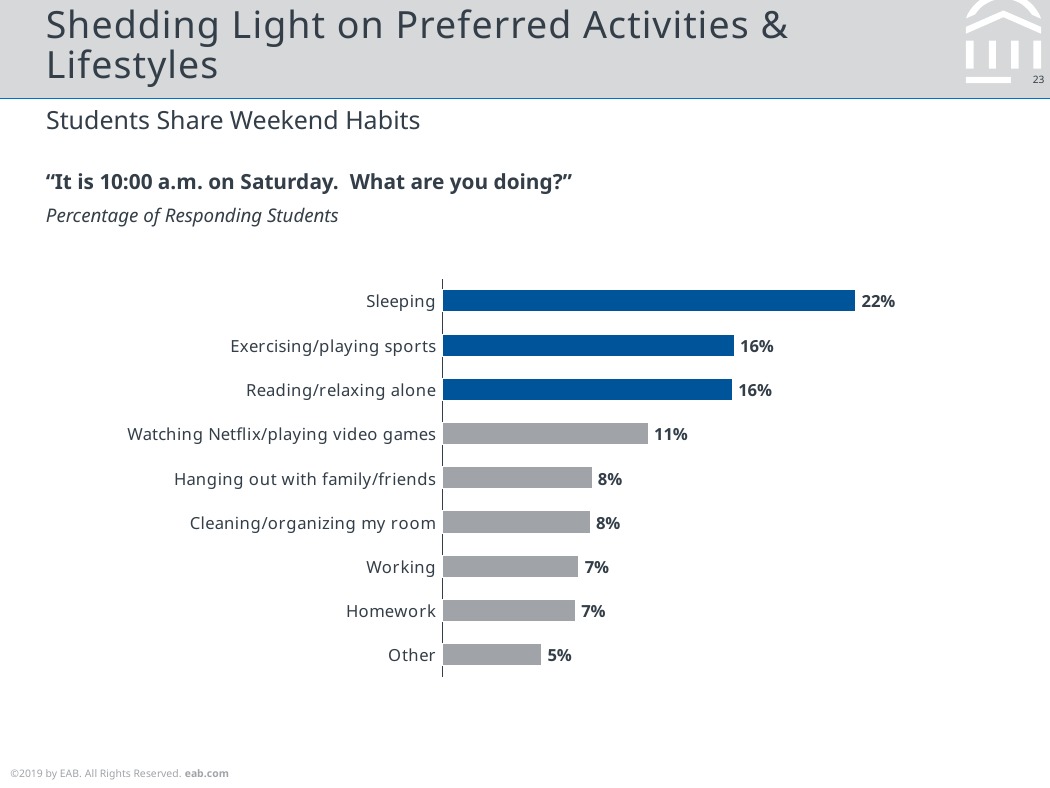
What kind of chart is used to show the weekend habits data? Bar chart What percentage of responding students said they are watching Netflix/playing video games? 11% Which activity has the highest percentage of responding students? Sleeping What percentage of responding students said they are doing homework? 7% What is the difference in percentage points between Watching Netflix/playing video games and Hanging out with family/friends? 3 What percentage of responding students said they are sleeping at 10:00 a.m. on Saturday? 22% Which activity has the lowest percentage of responding students? Other What question were students asked, according to the text above the chart? "It is 10:00 a.m. on Saturday. What are you doing?" Which has a higher percentage: Reading/relaxing alone or Cleaning/organizing my room? Reading/relaxing alone How many activity categories are shown in the chart? 9 What is the difference in percentage points between Sleeping and Exercising/playing sports? 6 How many of the bars are coloured blue rather than grey? 3